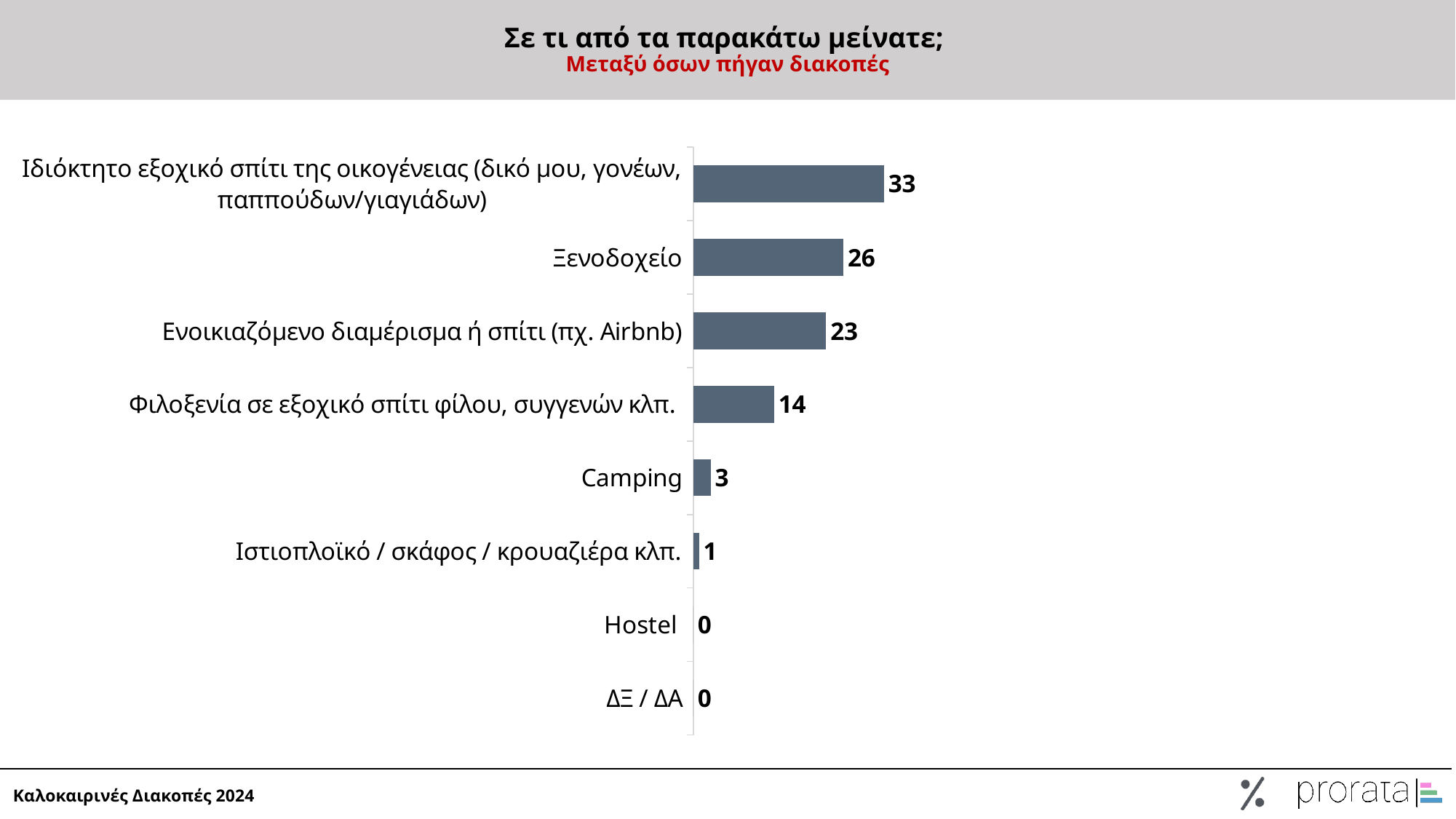
What is the difference between the values for Ιδιόκτητο εξοχικό σπίτι της οικογένειας and Φιλοξενία σε εξοχικό σπίτι φίλου, συγγενών κλπ.? 19 Which is larger, the value for Ξενοδοχείο or the value for Ενοικιαζόμενο διαμέρισμα ή σπίτι (πχ. Airbnb)? Ξενοδοχείο What kind of chart is shown on the slide? Bar chart What is the red subtitle under the chart title? Μεταξύ όσων πήγαν διακοπές Which category has the highest value? Ιδιόκτητο εξοχικό σπίτι της οικογένειας (δικό μου, γονέων, παππούδων/γιαγιάδων) What is the value for Ξενοδοχείο? 26 How many categories are shown in the chart? 8 What is the value for Ιστιοπλοϊκό / σκάφος / κρουαζιέρα κλπ.? 1 What is the value for Φιλοξενία σε εξοχικό σπίτι φίλου, συγγενών κλπ.? 14 Which categories have a value of 0? Hostel and ΔΞ / ΔΑ What is the difference between the values for Ξενοδοχείο and Ενοικιαζόμενο διαμέρισμα ή σπίτι (πχ. Airbnb)? 3 What is the value for Camping? 3